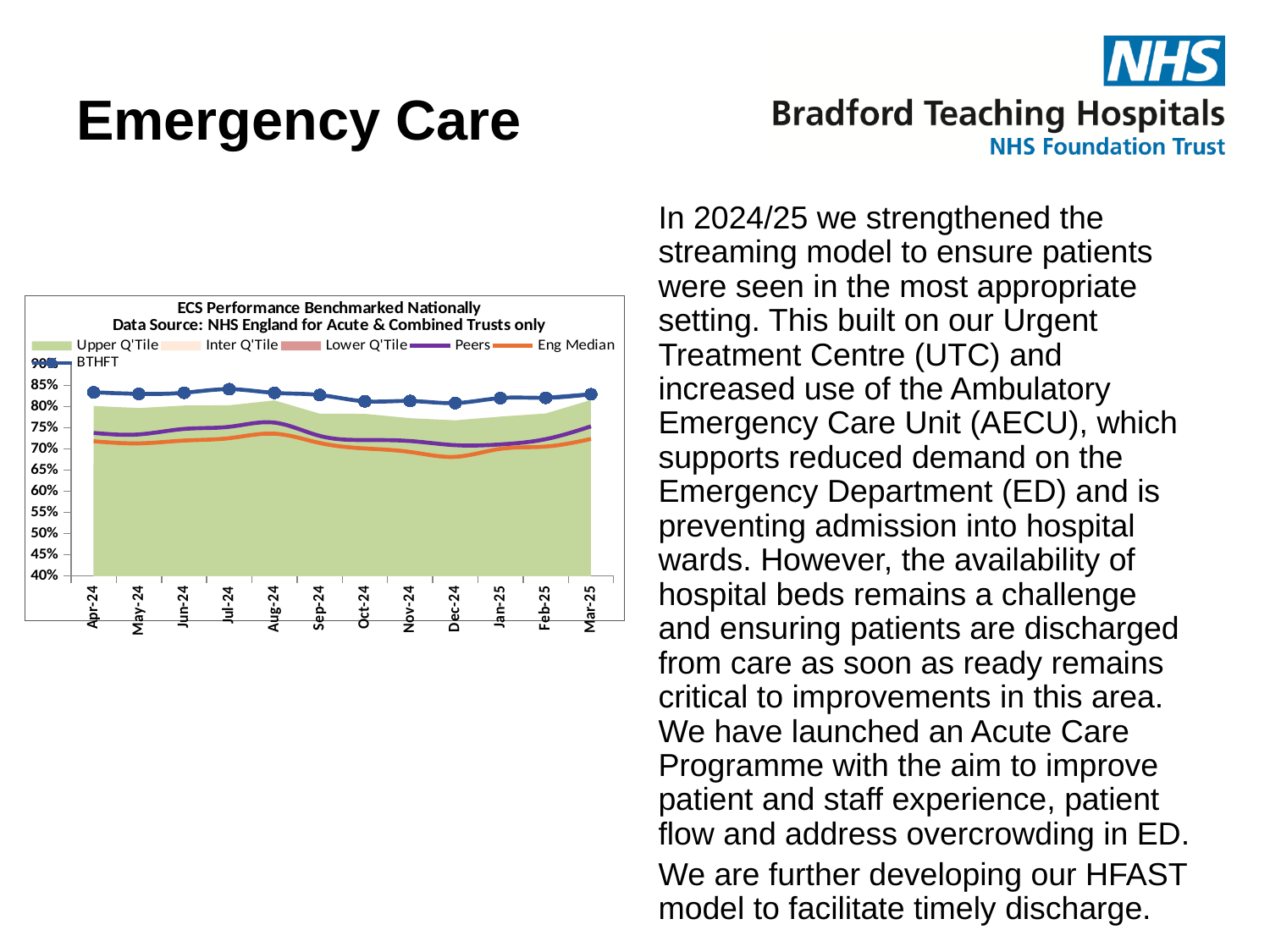
What data source is named in the chart subtitle? NHS England for Acute & Combined Trusts only What kind of chart is shown on the slide? combination area and line chart Is the Peers value for Dec-24 greater or less than 75%? less Is the BTHFT value for Mar-25 greater or less than 80%? greater In Apr-24, which is larger: the BTHFT value or the Peers value? BTHFT Is the Eng Median value for Dec-24 greater or less than 70%? less How many months are shown on the x axis of the chart? 12 In Dec-24, which is larger: the Peers value or the Eng Median value? Peers What is the title of the chart? ECS Performance Benchmarked Nationally Does the Eng Median line rise or fall from Aug-24 to Dec-24? fall How many series does the chart legend list? 6